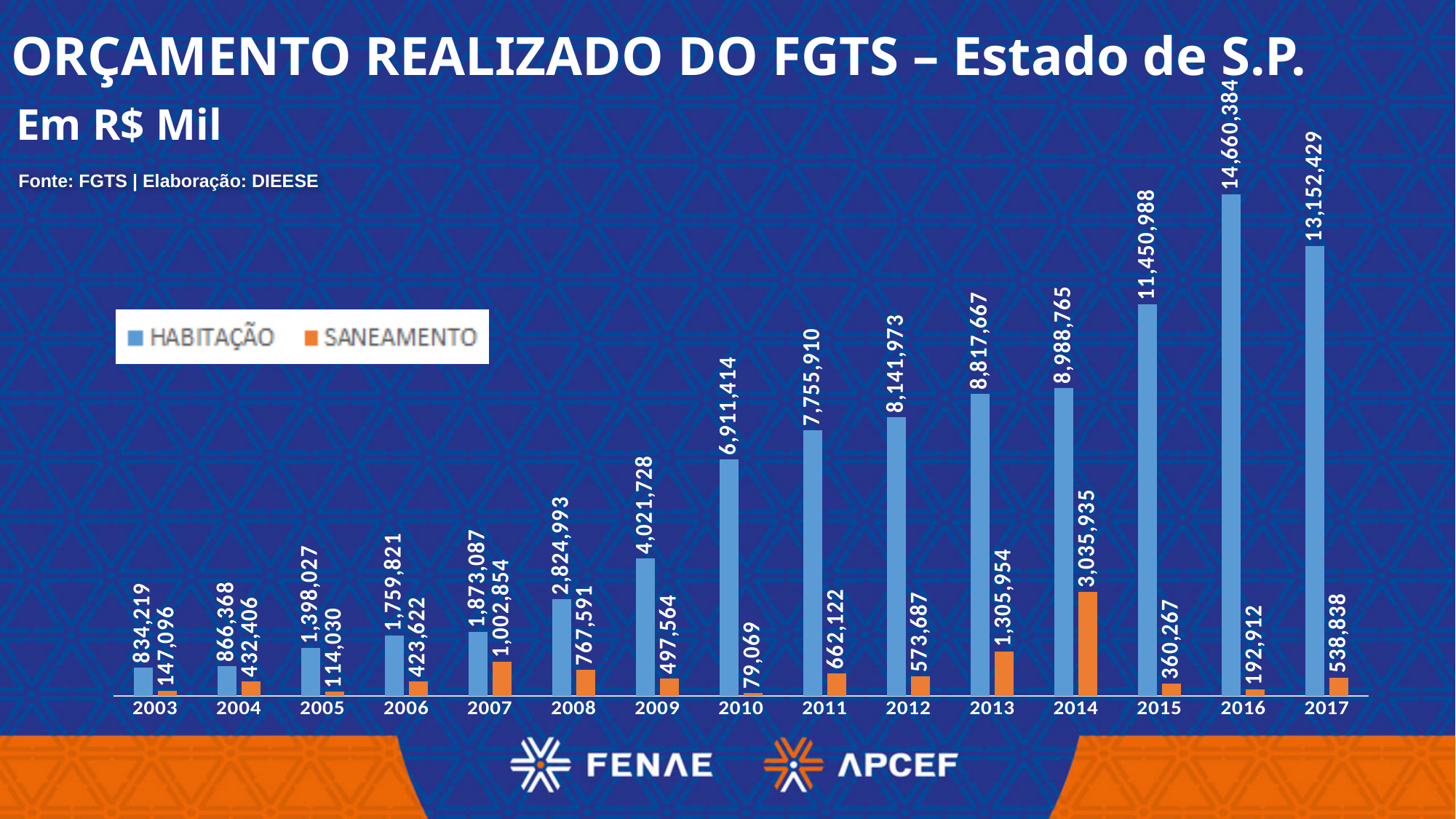
How many series does the legend list? 2 What is the HABITAÇÃO value for 2010? 6,911,414 Which is larger, the SANEAMENTO value for 2004 or for 2006? 2004 What is the difference between the HABITAÇÃO values for 2016 and 2017? 1,507,955 Which year has the highest SANEAMENTO value? 2014 What unit is stated in the subtitle of the chart? Em R$ Mil Which year has the highest HABITAÇÃO value? 2016 What kind of chart is shown on the slide? Bar chart Which year has the lowest SANEAMENTO value? 2010 What is the SANEAMENTO value for 2007? 1,002,854 How many years are shown on the x axis? 15 What is the HABITAÇÃO value for 2015? 11,450,988